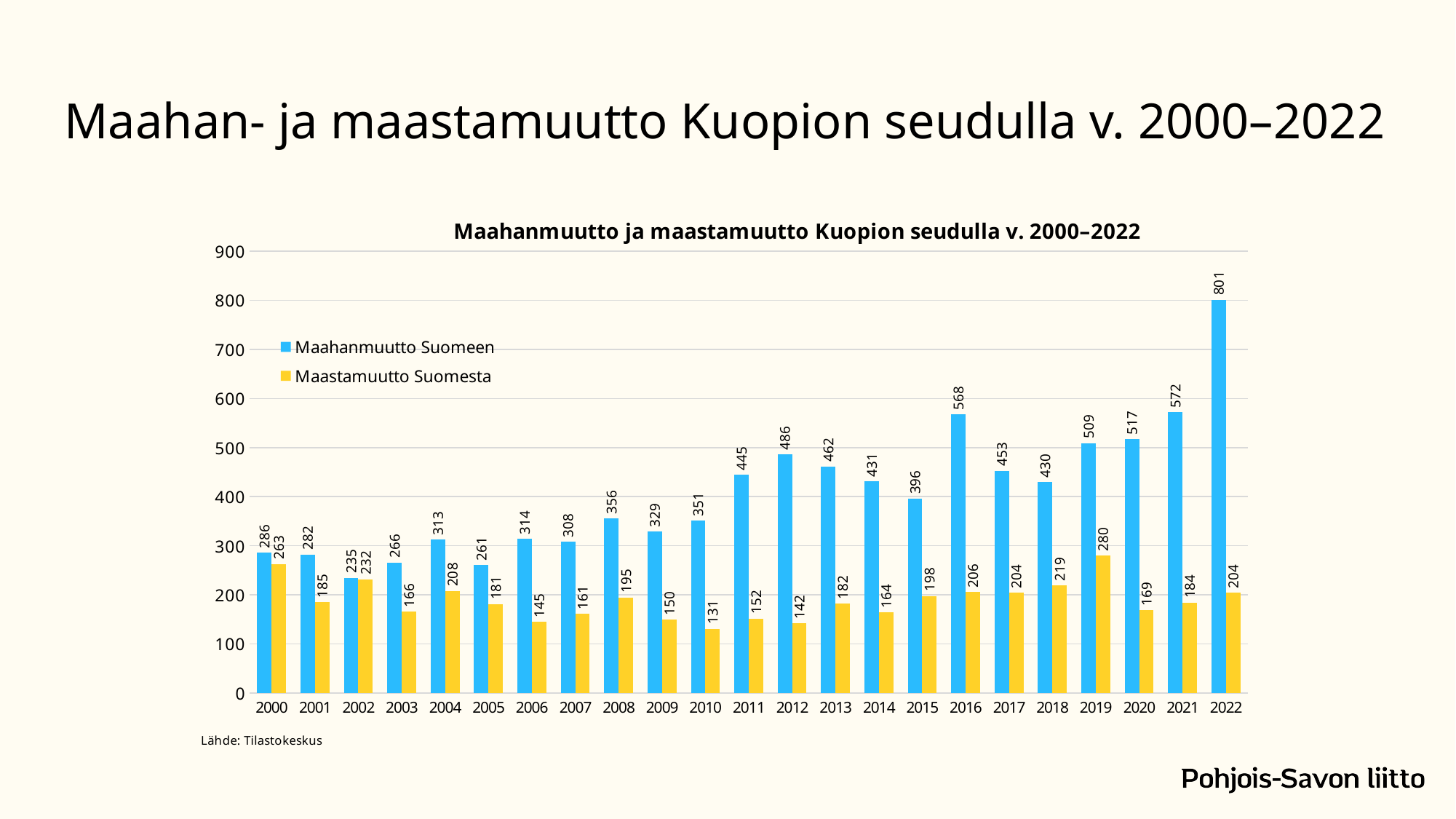
Which year has the highest value for Maahanmuutto Suomeen? 2022 Is the value for Maahanmuutto Suomeen in 2016 greater or less than 500? greater What is the value of Maahanmuutto Suomeen in 2010? 351 What is the difference between Maahanmuutto Suomeen and Maastamuutto Suomesta in 2022? 597 What is the value of Maastamuutto Suomesta in 2019? 280 What is the title of the chart? Maahanmuutto ja maastamuutto Kuopion seudulla v. 2000–2022 What kind of chart is shown on the slide? Bar chart What is the value of Maahanmuutto Suomeen in 2022? 801 How many series does the legend list? 2 How many years are shown on the x axis? 23 Which is larger in 2002: Maahanmuutto Suomeen or Maastamuutto Suomesta? Maahanmuutto Suomeen Which year has the lowest value for Maastamuutto Suomesta? 2010